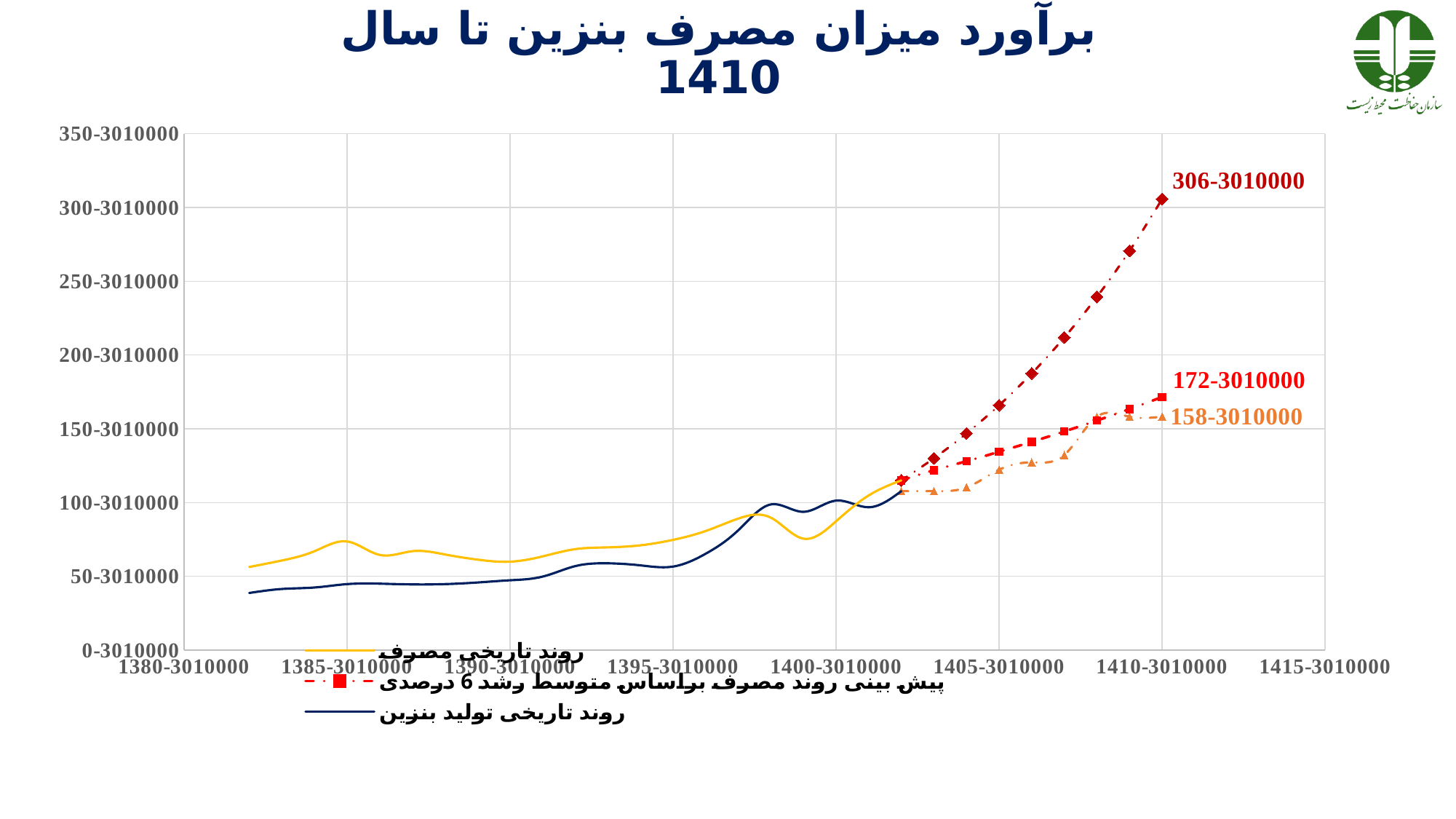
What is the final labeled value of the series 'پیش بینی روند مصرف براساس متوسط رشد 6 درصدی' (red dashed line with square markers)? 172-3010000 Is the starting value of the series 'روند تاریخی تولید بنزین' (navy line) greater or less than the 50-3010000 axis tick? less What is the title of the chart? برآورد میزان مصرف بنزین تا سال 1410 What is the labeled end value of the dashed line with diamond markers at 1410-3010000? 306-3010000 What kind of chart is shown on the slide? line chart Is the starting value of the series 'روند تاریخی مصرف' (yellow line) greater or less than the 50-3010000 axis tick? greater What is the lowest data label printed on the chart? 158-3010000 What colour is the line for 'روند تاریخی مصرف'? yellow Which labeled end value is larger: the one on the line with diamond markers or the one on the line with square markers? the line with diamond markers (306-3010000) How many series does the legend list? 3 Do the forecast lines after 1400-3010000 rise or fall along the x axis? rise What is the highest data label printed on the chart? 306-3010000